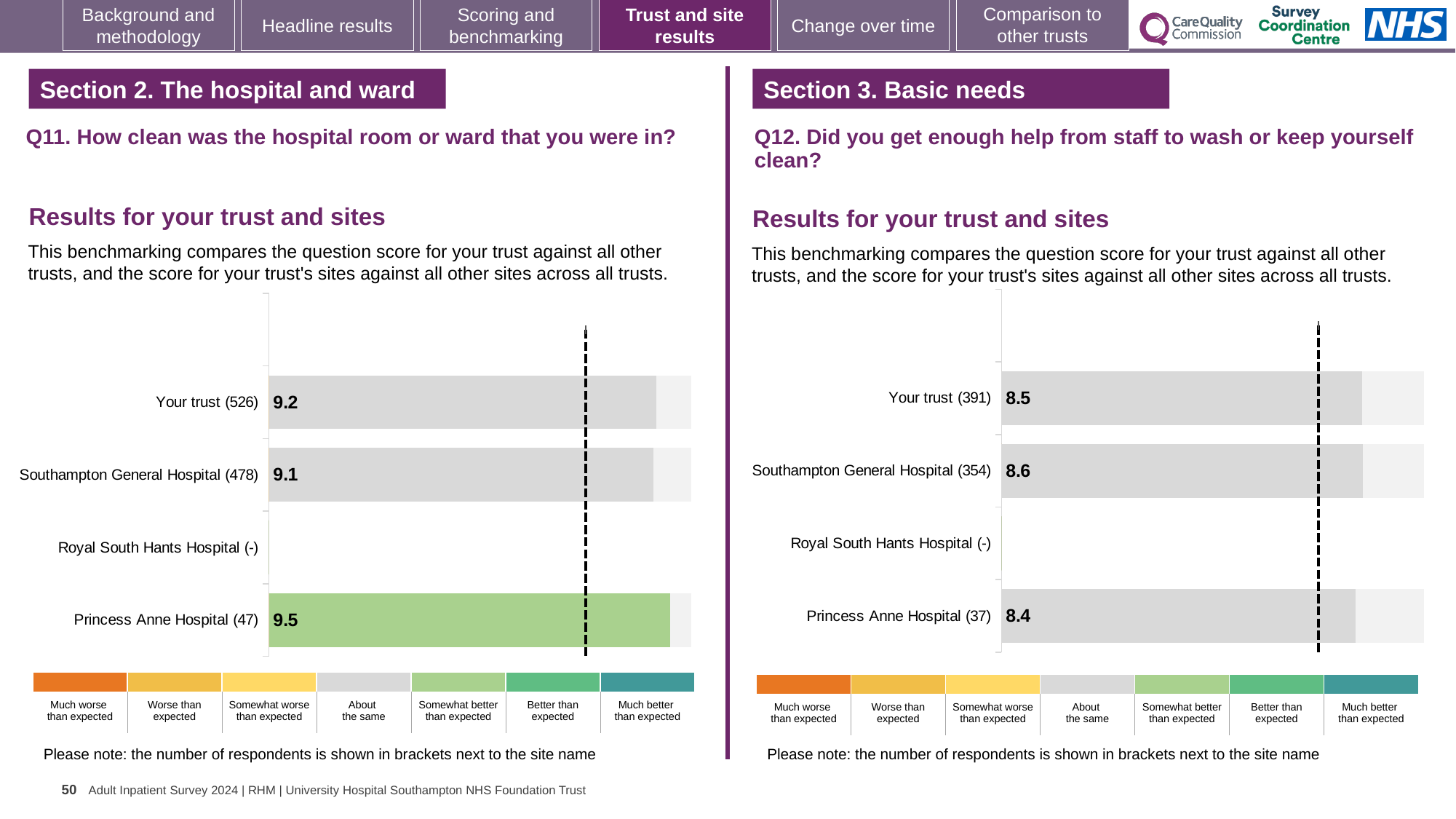
In the Q12 chart (right), what is the score for Southampton General Hospital (354)? 8.6 How many site or trust rows are listed in the Q11 chart (left)? 4 In the Q11 chart (left), what is the score for Your trust (526)? 9.2 What kind of chart is used for the Q12 results (right)? Bar chart In the Q11 chart (left), what is the score for Princess Anne Hospital (47)? 9.5 In the Q11 chart (left), which benchmark category does the green colour of the Princess Anne Hospital bar represent? Somewhat better than expected In the Q12 chart (right), which has the higher score: Your trust or Southampton General Hospital? Southampton General Hospital In the Q12 chart (right), which row with a plotted score has the lowest score? Princess Anne Hospital (37) In the Q12 chart (right), what is the difference between the scores for Southampton General Hospital and Princess Anne Hospital? 0.2 In the Q12 chart (right), what is the score for Princess Anne Hospital (37)? 8.4 In the Q11 chart (left), which site or trust has the highest score? Princess Anne Hospital (47) In the Q11 chart (left), what is the difference between the scores for Princess Anne Hospital and Southampton General Hospital? 0.4